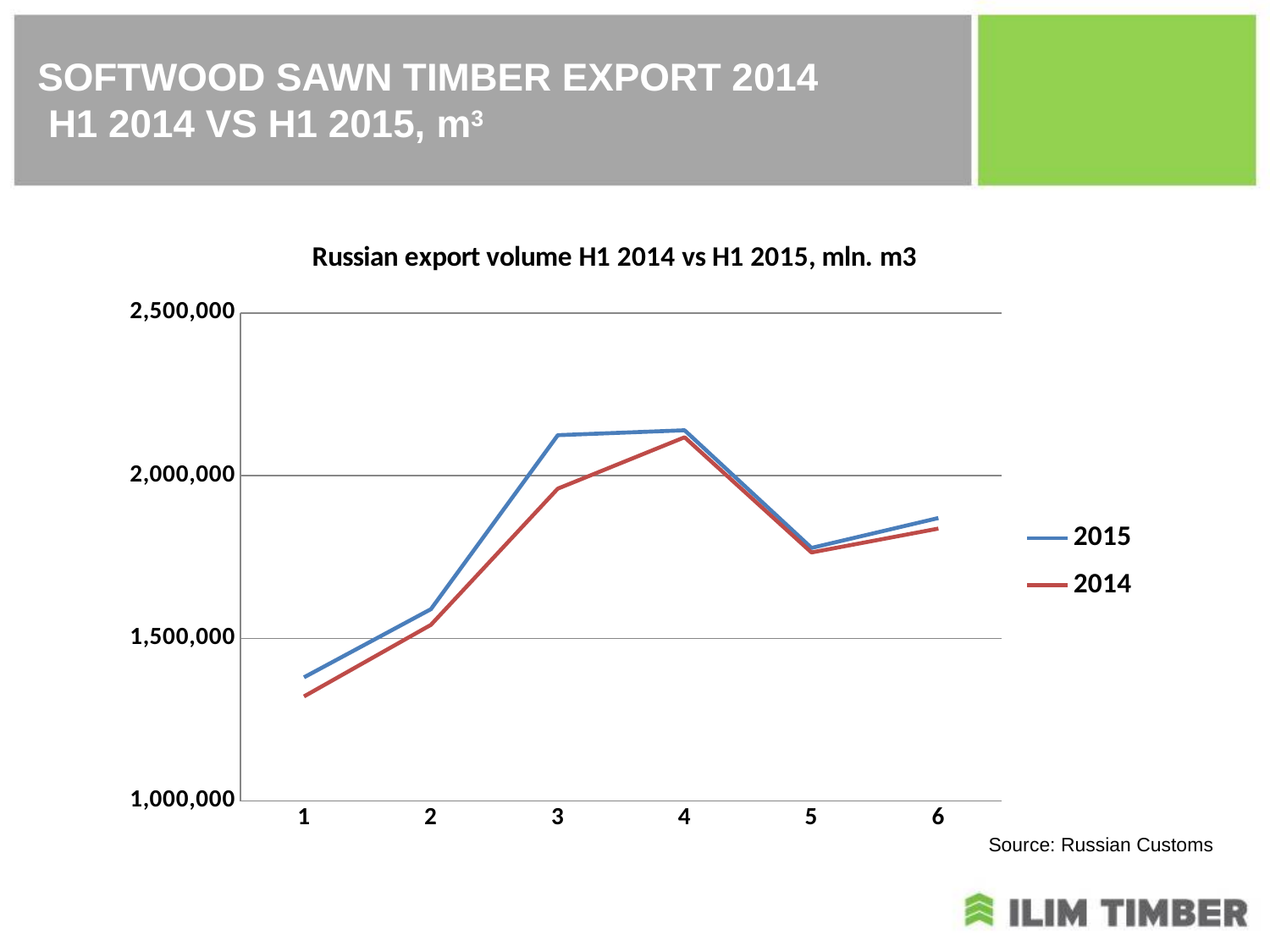
Is the 2015 value at point 3 greater or less than 2,000,000? greater At which point on the x axis is the 2014 series highest? 4 How many points are plotted along the x axis for each series? 6 What kind of chart is shown on the slide? line chart At which point on the x axis is the 2015 series lowest? 1 What is the title of the chart? Russian export volume H1 2014 vs H1 2015, mln. m3 Is the 2014 value at point 1 greater or less than 1,500,000? less At point 3, which series has the larger value, 2015 or 2014? 2015 How many series does the legend list? 2 Is the 2015 value at point 2 greater or less than 1,500,000? greater Does the 2015 series rise or fall from point 1 to point 3? rise